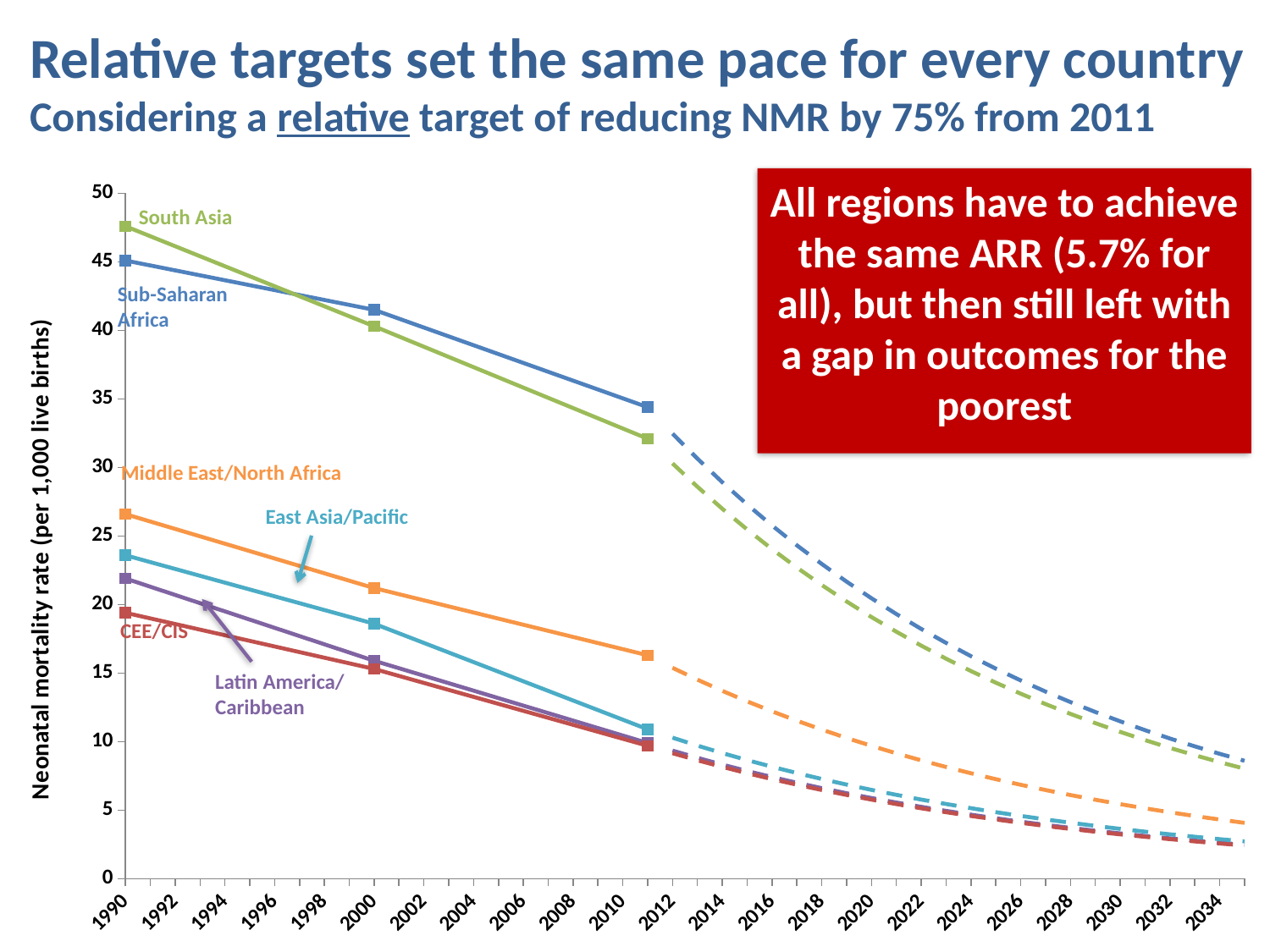
Is the value for East Asia/Pacific in 1990 greater or less than 25? less What is the label on the vertical axis of the chart? Neonatal mortality rate (per 1,000 live births) Is the value for Middle East/North Africa in 1990 greater or less than 25? greater Does the neonatal mortality rate for South Asia rise or fall from 1990 to 2011? fall In 2000, which is larger: the value for Middle East/North Africa or the value for East Asia/Pacific? Middle East/North Africa Is the value for Middle East/North Africa in 2011 greater or less than 15? greater Which region has the highest neonatal mortality rate in 1990? South Asia How many regions are plotted on the chart? 6 Which region has the lowest neonatal mortality rate in 1990? CEE/CIS What kind of chart is shown on the slide? line chart Which region has the highest neonatal mortality rate in 2011? Sub-Saharan Africa